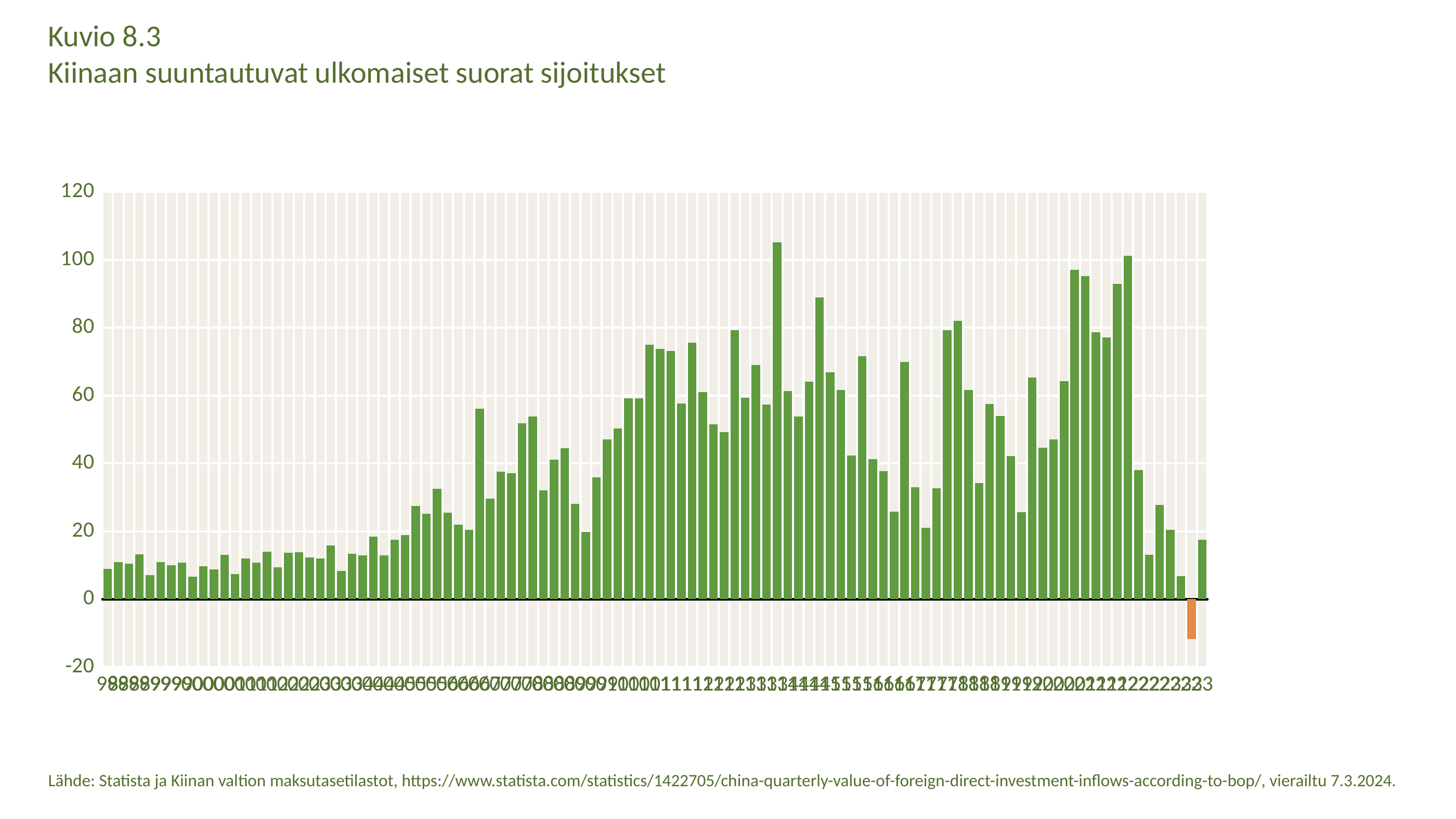
Is the value of the tallest bar greater or less than 100? greater Is the value of the tallest bar greater or less than 120? less What is the highest value shown on the vertical axis? 120 Is the value of the last (rightmost) bar greater or less than 20? less What is the title of the chart? Kiinaan suuntautuvat ulkomaiset suorat sijoitukset Moving from the left edge of the chart toward the middle, do the bar values generally rise or fall? rise What colour are most of the bars in the chart? green What kind of chart is shown on the slide? bar chart How many bars in the chart extend below zero? 1